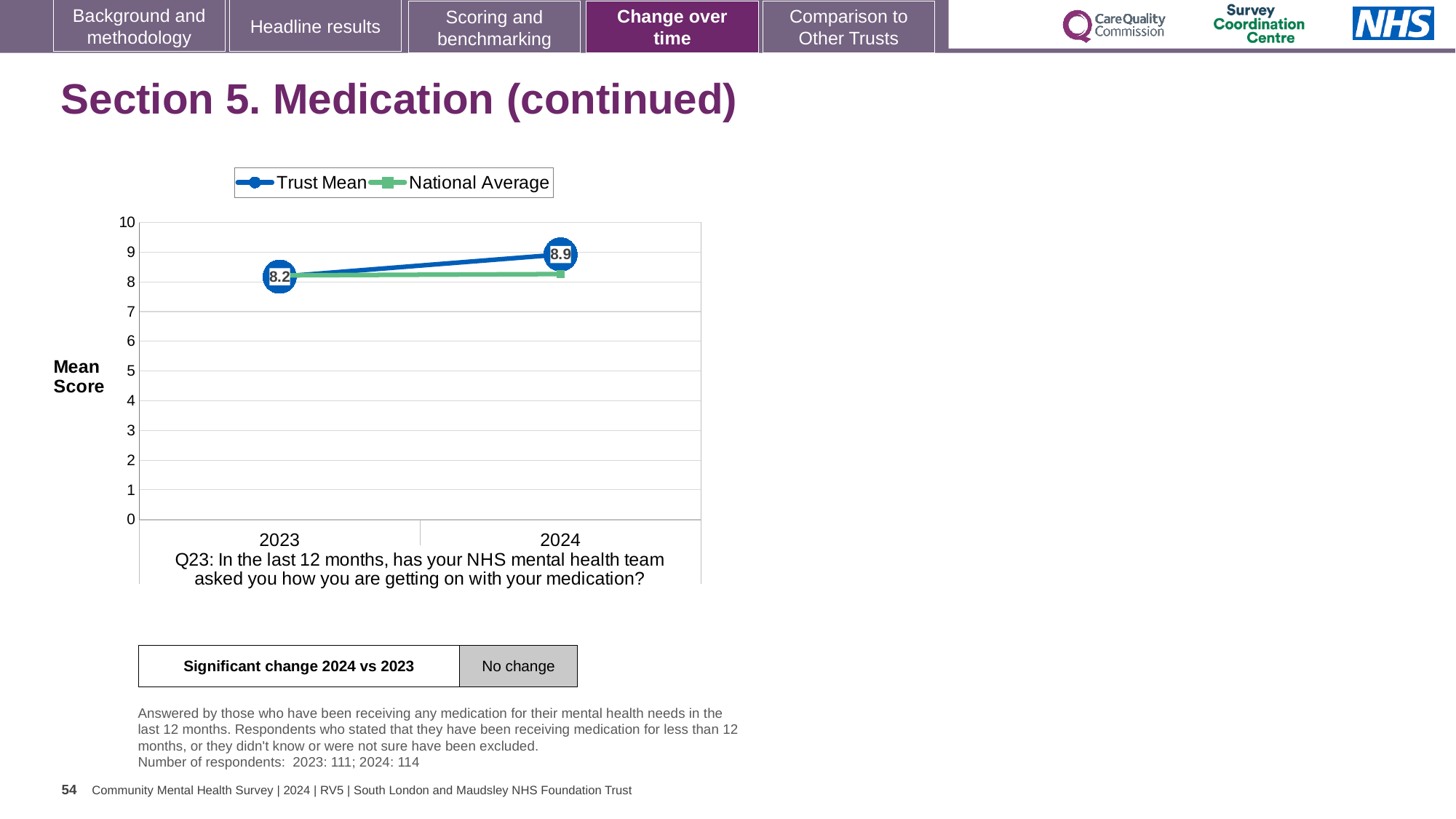
What kind of chart is shown on the slide? line chart By how much did the Trust Mean change from 2023 to 2024? 0.7 What is the Trust Mean value for 2023? 8.2 What is the label on the vertical axis of the chart? Mean Score What is the Trust Mean value for 2024? 8.9 How many years are plotted on the x axis? 2 Which year has the higher Trust Mean, 2023 or 2024? 2024 What are the two series named in the legend? Trust Mean and National Average Is the National Average value for 2024 greater or less than 9? less In 2024, which is larger, the Trust Mean or the National Average? Trust Mean How many series does the legend list? 2 Does the Trust Mean rise or fall from 2023 to 2024? rise